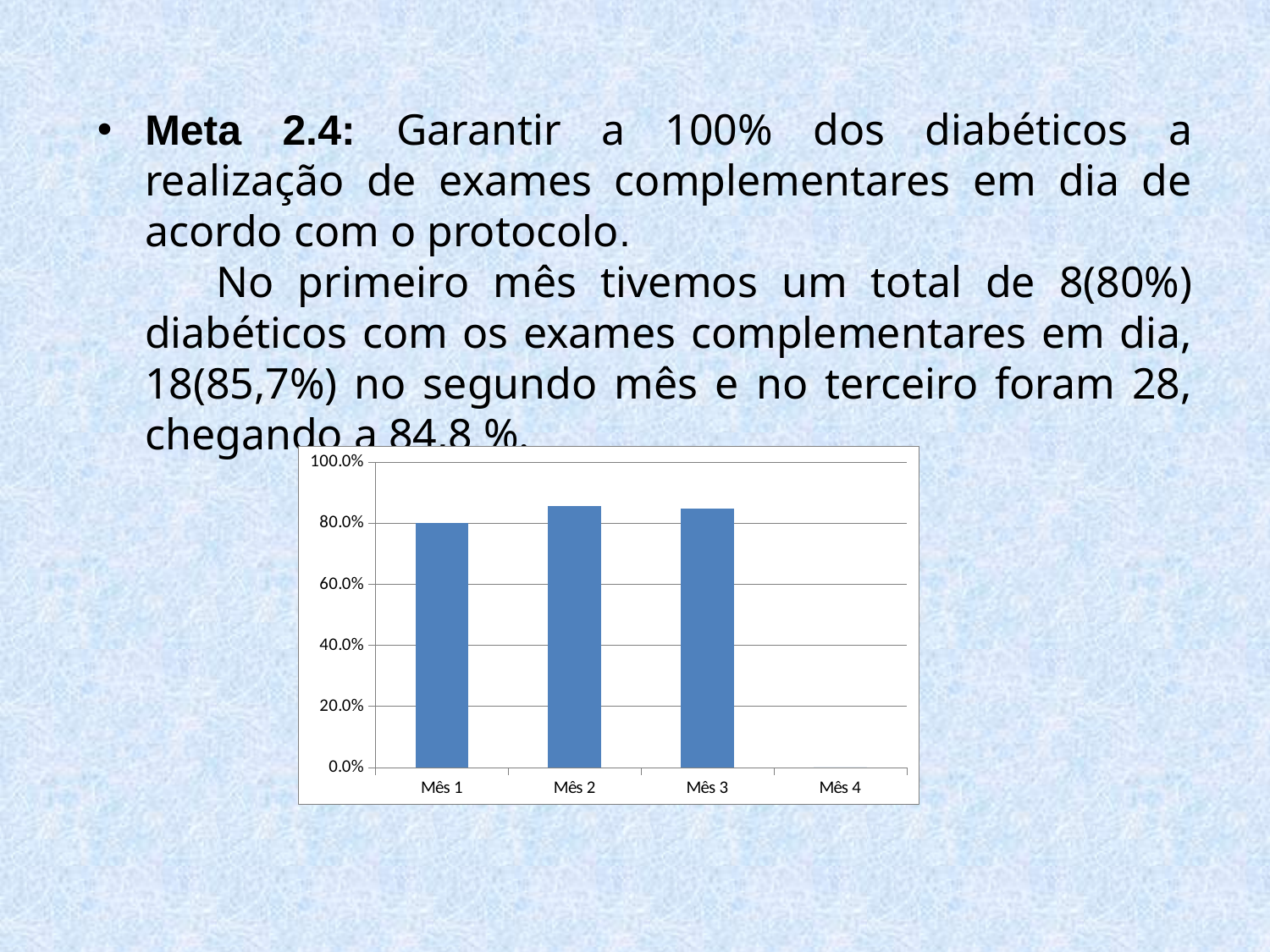
What is the highest value shown on the y axis of the chart? 100.0% Which category on the x axis has no bar plotted? Mês 4 Is the value for Mês 2 greater or less than 80.0%? greater Which is larger, the value for Mês 1 or the value for Mês 2? Mês 2 How many categories are shown on the x axis of the chart? 4 What kind of chart is shown on the slide? bar chart Is the value for Mês 2 greater or less than 100.0%? less Is the value for Mês 3 greater or less than 80.0%? greater What is the value for Mês 1? 80.0% Which is larger, the value for Mês 1 or the value for Mês 3? Mês 3 Does the value rise or fall from Mês 1 to Mês 2? rise